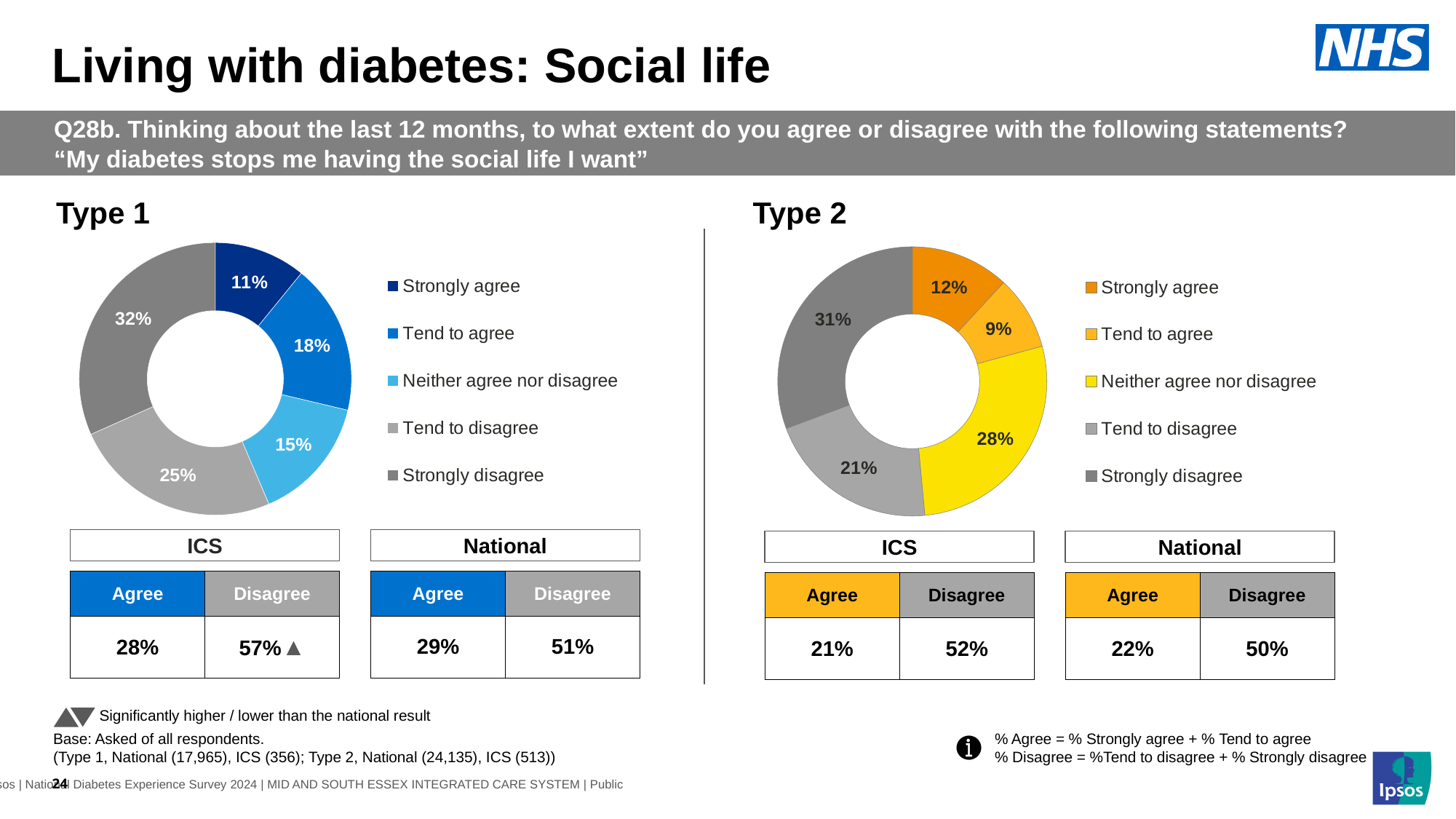
In the Type 2 chart, what percentage of respondents said they tend to agree? 9% In the Type 2 chart, which is larger: Neither agree nor disagree or Tend to disagree? Neither agree nor disagree What kind of chart is used for Type 1? Donut chart In the Type 1 chart, what is the difference between the Strongly disagree share and the Tend to disagree share? 7% In the Type 2 chart, which response category has the smallest share? Tend to agree In the Type 2 chart, what percentage of respondents said they strongly disagree? 31% In the Type 1 chart, what is the combined share of Strongly agree and Tend to agree? 29% In the Type 1 chart, what percentage of respondents said Neither agree nor disagree? 15% In the Type 1 chart, what percentage of respondents said they strongly agree? 11% In the Type 1 chart, which response category has the largest share? Strongly disagree How many entries does the legend of the Type 1 chart list? 5 How many response categories are shown in the Type 2 chart? 5